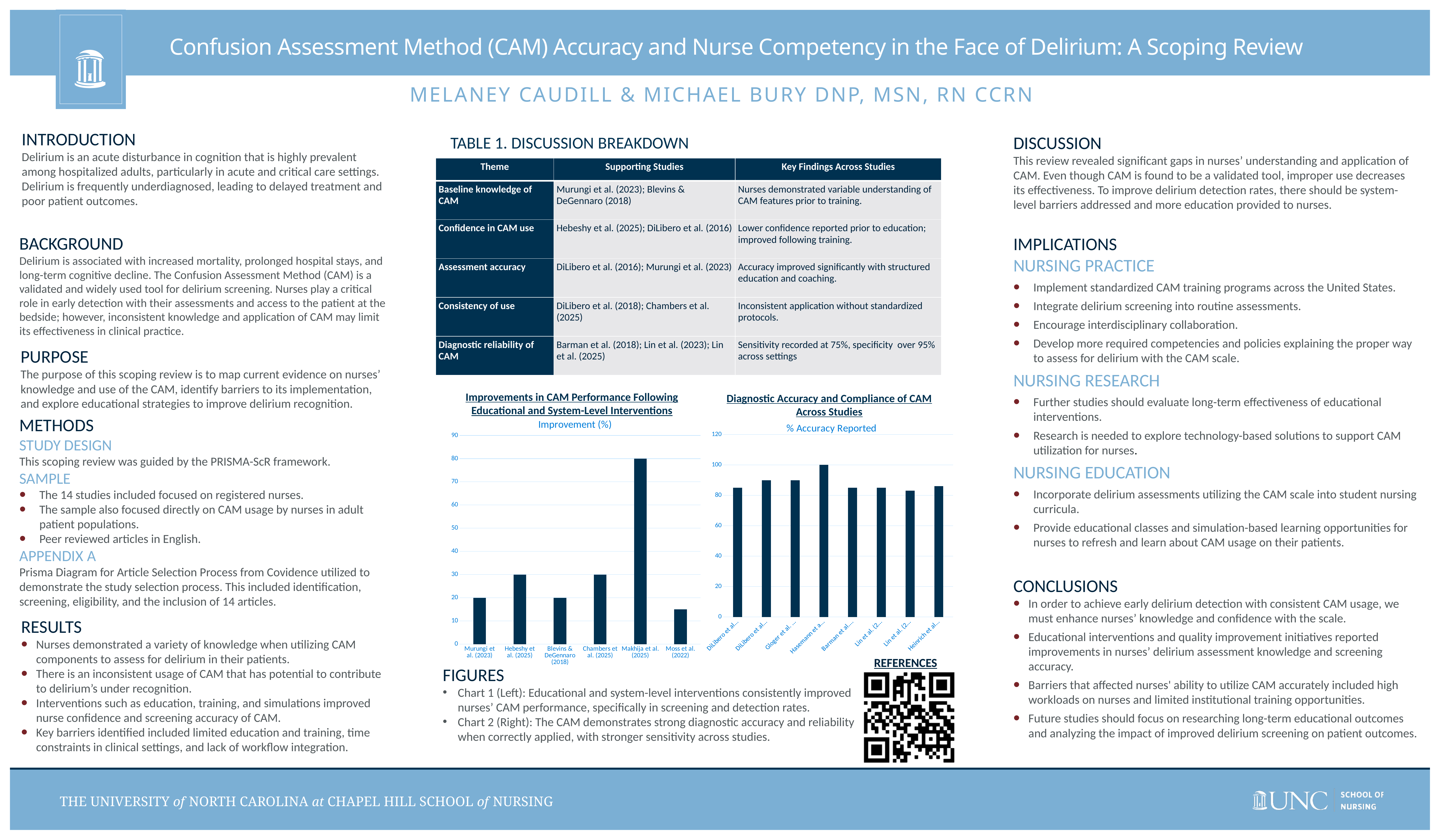
In the left chart (Improvements in CAM Performance), what is the difference in improvement (%) between Makhija et al. (2025) and Chambers et al. (2025)? 50 In the left chart (Improvements in CAM Performance), is the value for Moss et al. (2022) greater or less than 20? less In the right chart (Diagnostic Accuracy and Compliance of CAM Across Studies), is the value for Gloger et al. greater or less than 80? greater In the left chart (Improvements in CAM Performance), which study has the highest improvement? Makhija et al. (2025) In the left chart (Improvements in CAM Performance), how many studies are plotted? 6 In the left chart (Improvements in CAM Performance), which has the larger improvement: Hebeshy et al. (2025) or Murungi et al. (2023)? Hebeshy et al. (2025) In the right chart (Diagnostic Accuracy and Compliance of CAM Across Studies), which study has the highest % accuracy reported? Hasemann et al. In the left chart (Improvements in CAM Performance), which study has the lowest improvement? Moss et al. (2022) In the left chart (Improvements in CAM Performance), what is the improvement (%) for Hebeshy et al. (2025)? 30 In the left chart (Improvements in CAM Performance), what is the improvement (%) for Makhija et al. (2025)? 80 What kind of chart is the left chart titled 'Improvements in CAM Performance Following Educational and System-Level Interventions'? Bar chart In the right chart (Diagnostic Accuracy and Compliance of CAM Across Studies), how many bars are plotted? 8